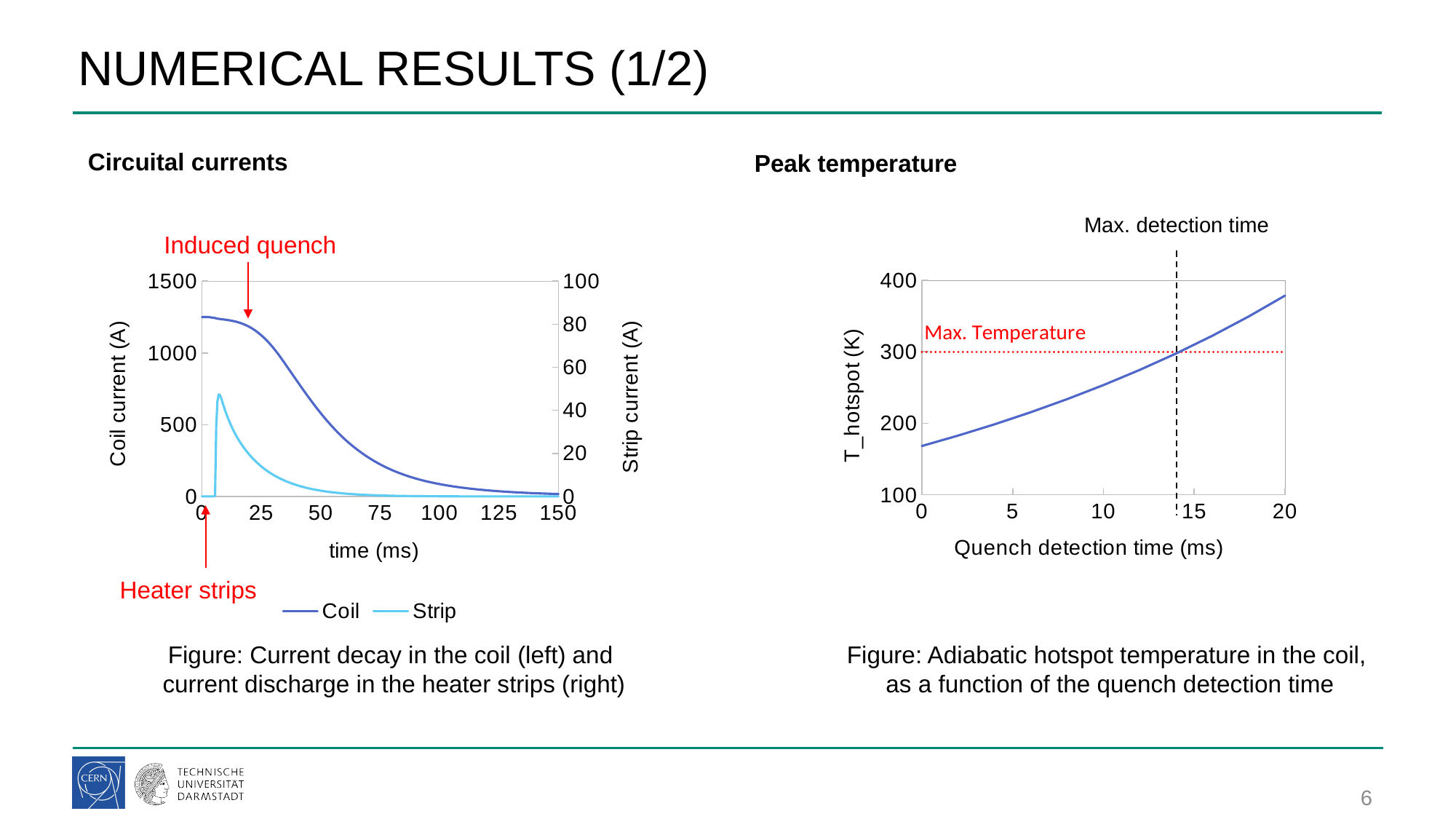
In the Peak temperature chart, is T_hotspot at a quench detection time of 0 ms greater or less than 200 K? less What kind of chart is the Circuital currents chart on the left? line chart In the Circuital currents chart, which series is plotted in light blue? Strip In the Circuital currents chart, is the coil current at 150 ms greater or less than 500 A? less In the Circuital currents chart, does the coil current rise or fall as time increases? fall How many series does the legend of the Circuital currents chart list? 2 What is the x-axis label of the Peak temperature chart on the right? Quench detection time (ms) In the Peak temperature chart, is T_hotspot at a quench detection time of 20 ms greater or less than 300 K? greater In the Peak temperature chart, does T_hotspot rise or fall as the quench detection time increases? rise